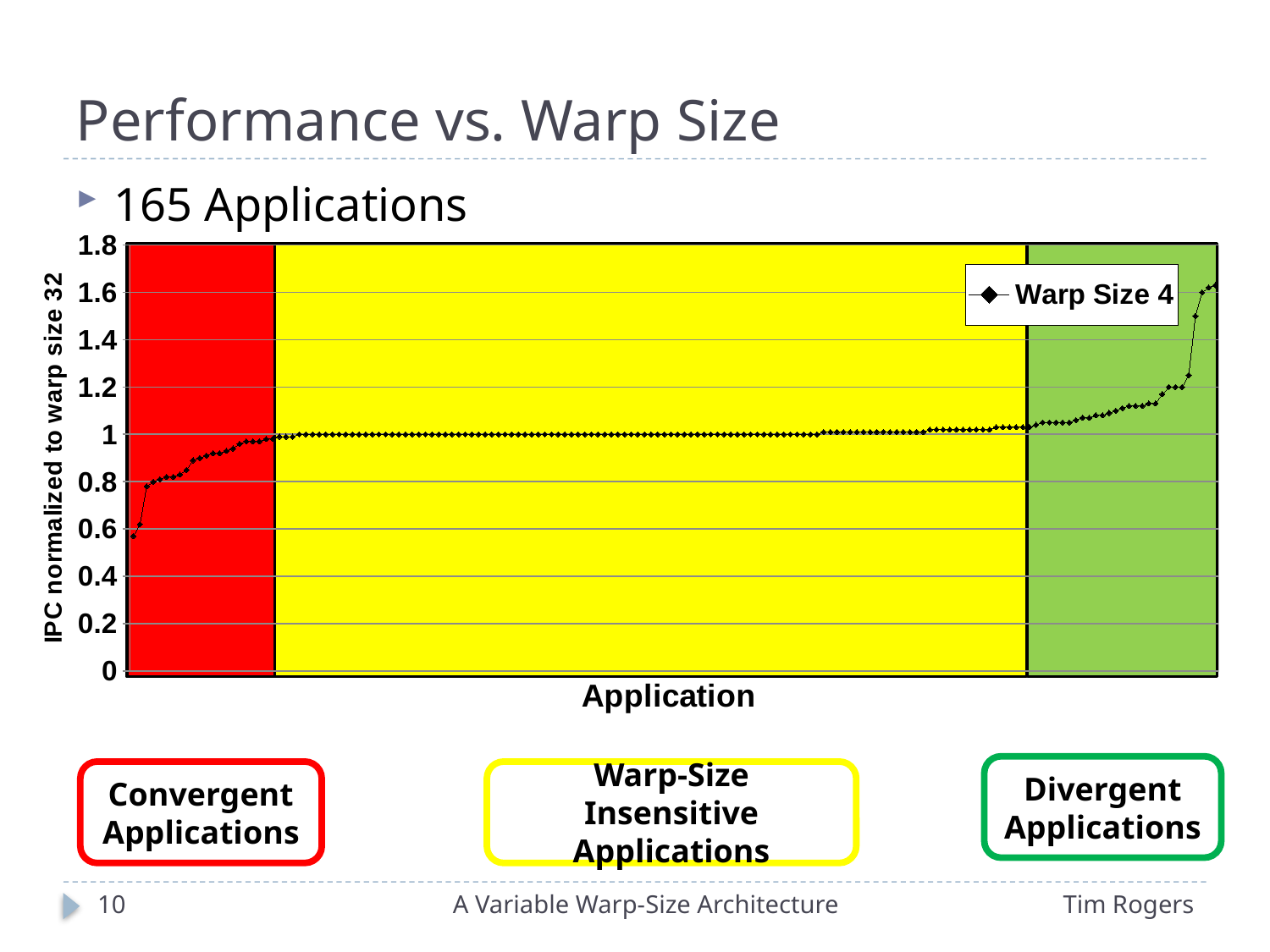
What is the name of the series shown in the chart legend? Warp Size 4 What is the title of the chart's y axis? IPC normalized to warp size 32 Is the Warp Size 4 value for the leftmost application greater or less than 0.4? greater Is the Warp Size 4 value for the rightmost application greater or less than 1.4? greater Is the Warp Size 4 value for the leftmost application greater or less than 0.8? less What kind of chart is shown on the slide? line chart Do the Warp Size 4 values rise or fall moving left to right along the x axis? rise How many applications are plotted in the chart, according to the slide? 165 Which has the larger Warp Size 4 value, the leftmost application or the rightmost application? the rightmost application What is the highest value shown on the chart's y axis? 1.8 How many series does the chart legend list? 1